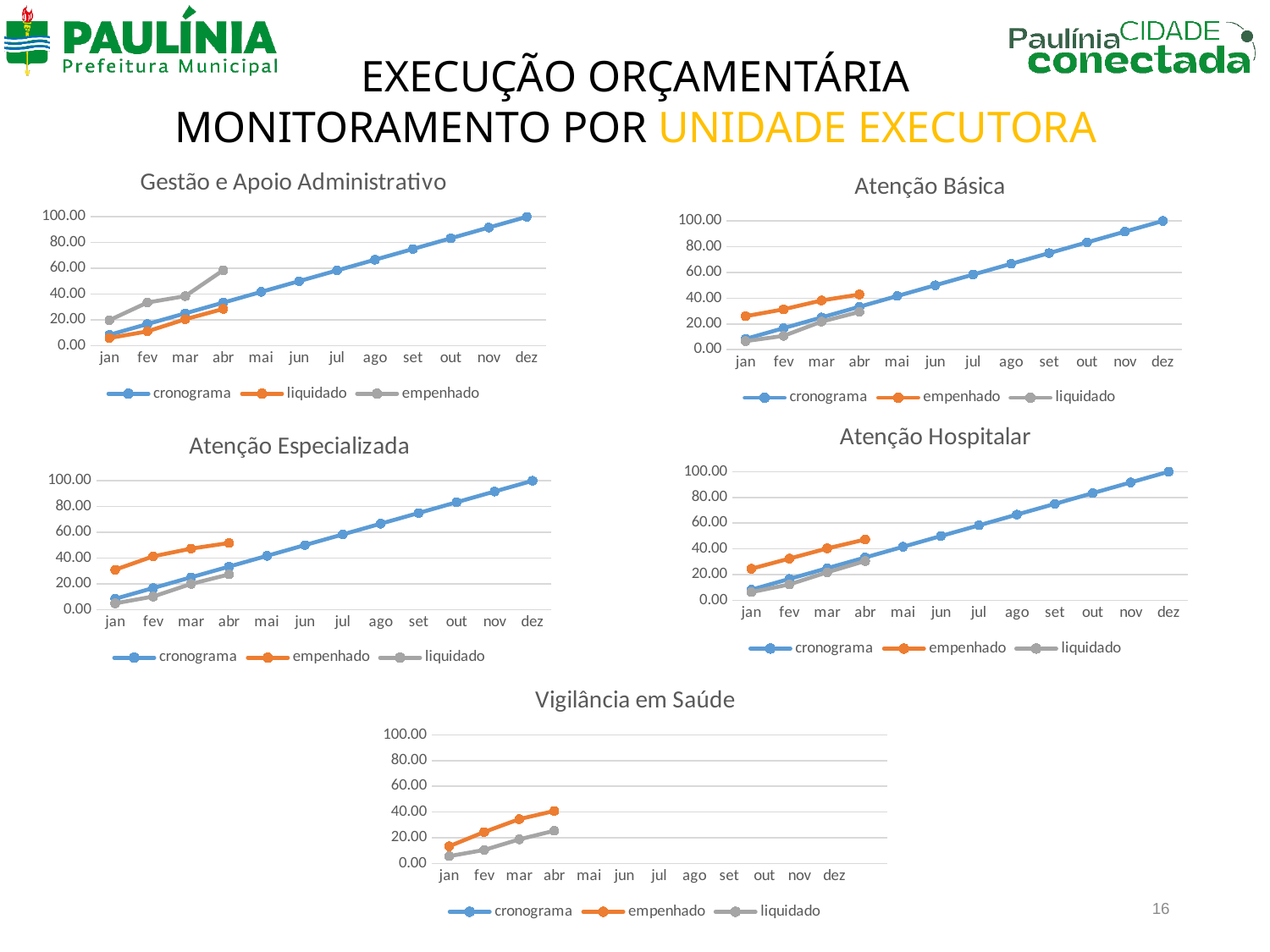
In the "Atenção Especializada" chart, is the value of empenhado in abr greater or less than 40.00? greater In the "Atenção Especializada" chart, which is larger in abr: empenhado or cronograma? empenhado In the "Atenção Básica" chart, does the cronograma series rise or fall from jan to dez? rise How many months are shown on the x axis of the "Vigilância em Saúde" chart? 12 In the "Vigilância em Saúde" chart, is the value of liquidado in abr greater or less than 20.00? greater In the "Gestão e Apoio Administrativo" chart, is the value of liquidado in abr greater or less than 40.00? less In the "Atenção Hospitalar" chart, what is the value of cronograma in dez? 100.00 In the "Gestão e Apoio Administrativo" chart, which is larger in abr: empenhado or liquidado? empenhado How many series does the legend of the "Atenção Básica" chart list? 3 What kind of chart is "Gestão e Apoio Administrativo"? line chart How many charts are shown on the slide? 5